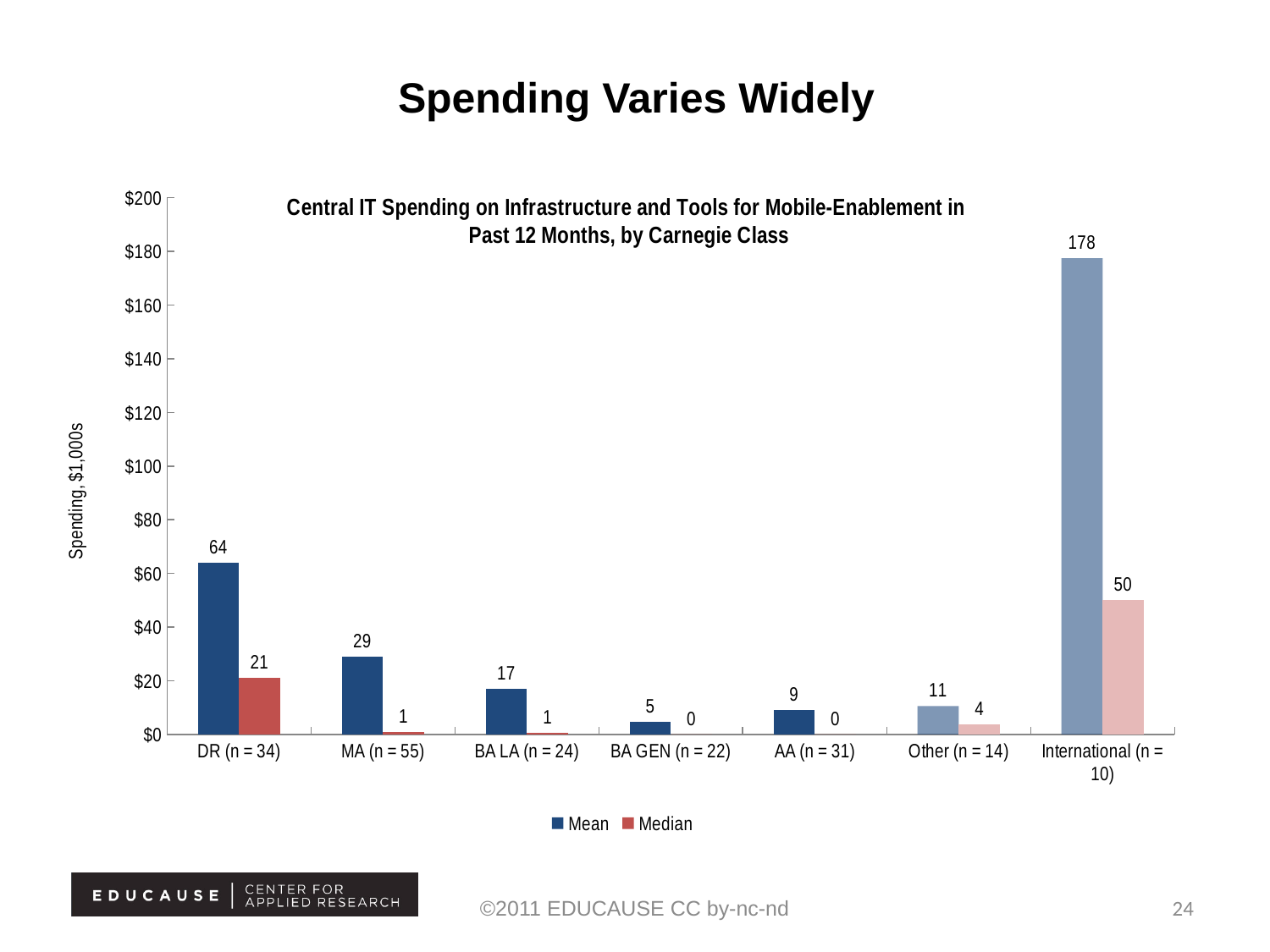
What is the Median value for International (n = 10)? 50 What is the Median value for AA (n = 31)? 0 What is the difference between the Mean and Median values for DR (n = 34)? 43 What is the Mean value for DR (n = 34)? 64 How many series does the legend list? 2 What is the Mean value for Other (n = 14)? 11 Which is larger, the Mean value for MA (n = 55) or the Mean value for BA LA (n = 24)? MA (n = 55) Which category has the lowest Mean value? BA GEN (n = 22) Which category has the highest Mean value? International (n = 10) How many categories are shown on the x axis? 7 What kind of chart is shown on the slide? Bar chart What is the label on the y axis? Spending, $1,000s